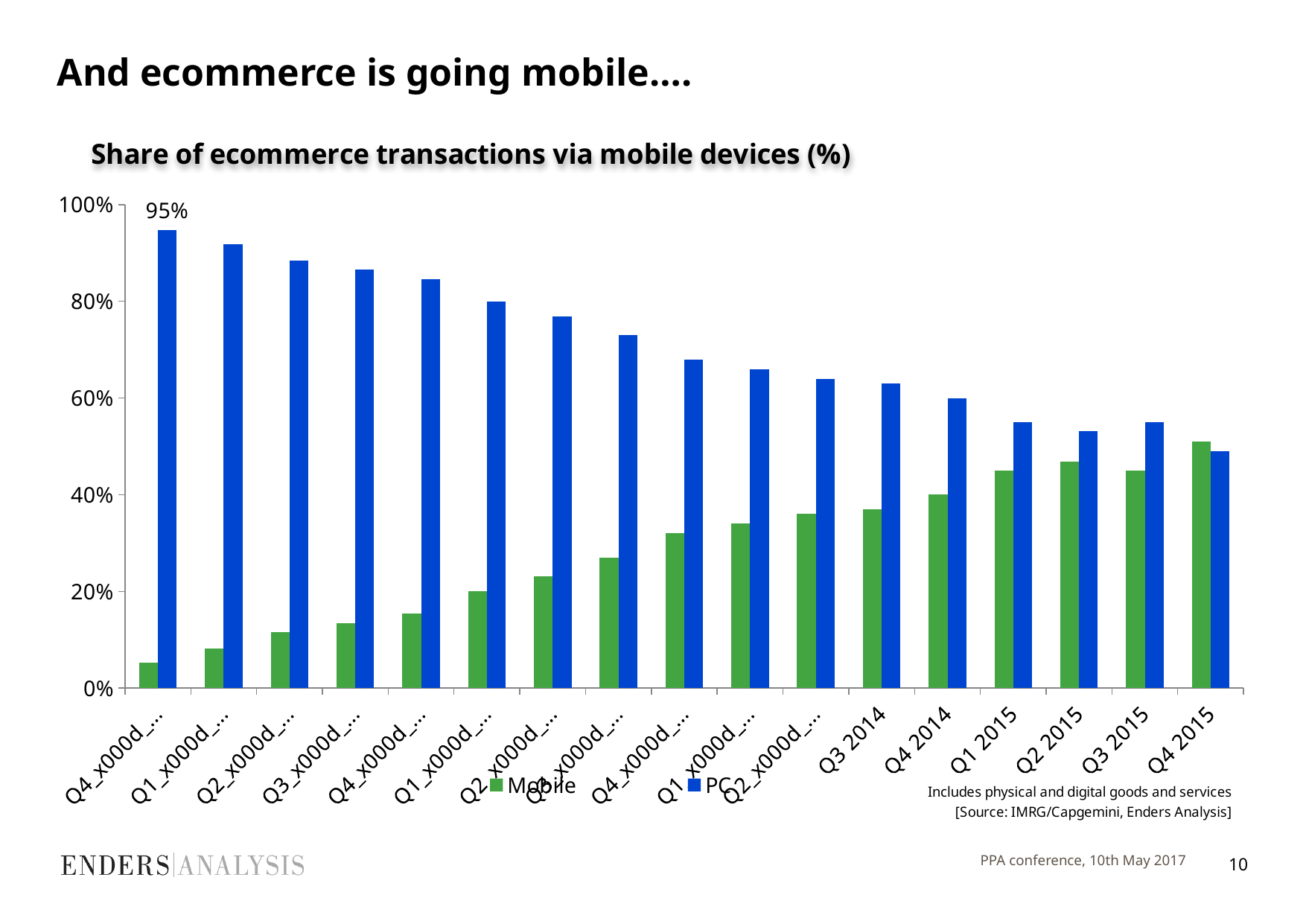
Is the Mobile value for Q3 2014 greater or less than 40%? less What value is printed as a data label on the leftmost PC bar? 95% In Q3 2015, which is larger, the Mobile share or the PC share? PC In which quarter is the Mobile share highest? Q4 2015 How many quarters (categories) are plotted along the x axis? 17 How many series does the legend list? 2 Which two series are shown in the legend? Mobile and PC In which quarter is the PC share lowest? Q4 2015 Does the Mobile series rise or fall from left to right along the x axis? rise What type of chart is shown on the slide? bar chart Is the PC value for Q3 2015 greater or less than 60%? less Does the PC series rise or fall from left to right along the x axis? fall